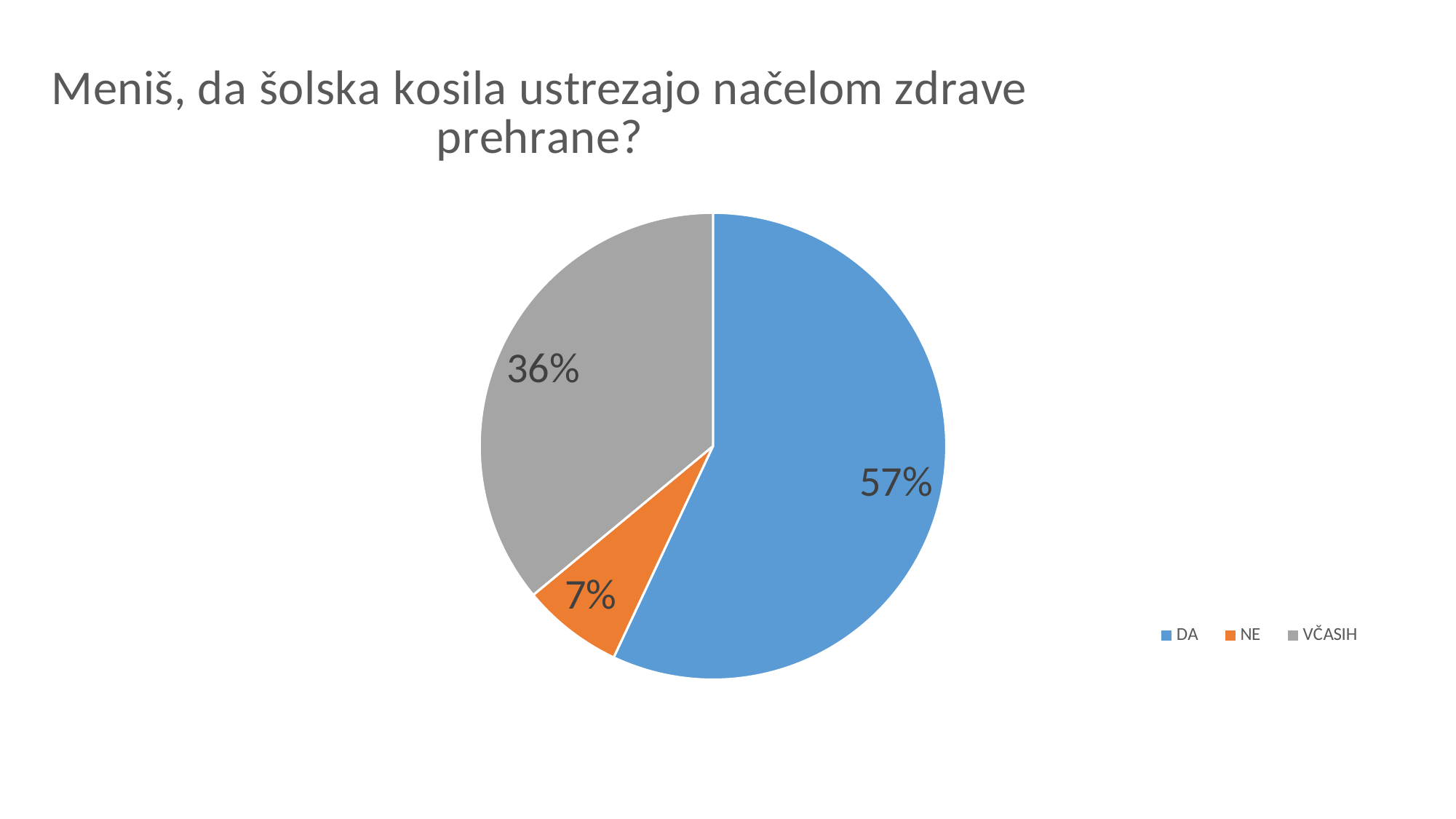
What share of the pie does VČASIH represent? 36% Which category has the smallest slice of the pie? NE What is the title of the chart? Meniš, da šolska kosila ustrezajo načelom zdrave prehrane? What kind of chart is shown on the slide? pie chart What colour is the slice for NE? orange What is the difference in percentage points between VČASIH and NE? 29 What share of the pie does NE represent? 7% How many categories does the pie chart show? 3 What share of the pie does DA represent? 57% Which is larger, the share for VČASIH or the share for NE? VČASIH What is the difference in percentage points between DA and VČASIH? 21 Which category has the largest slice of the pie? DA